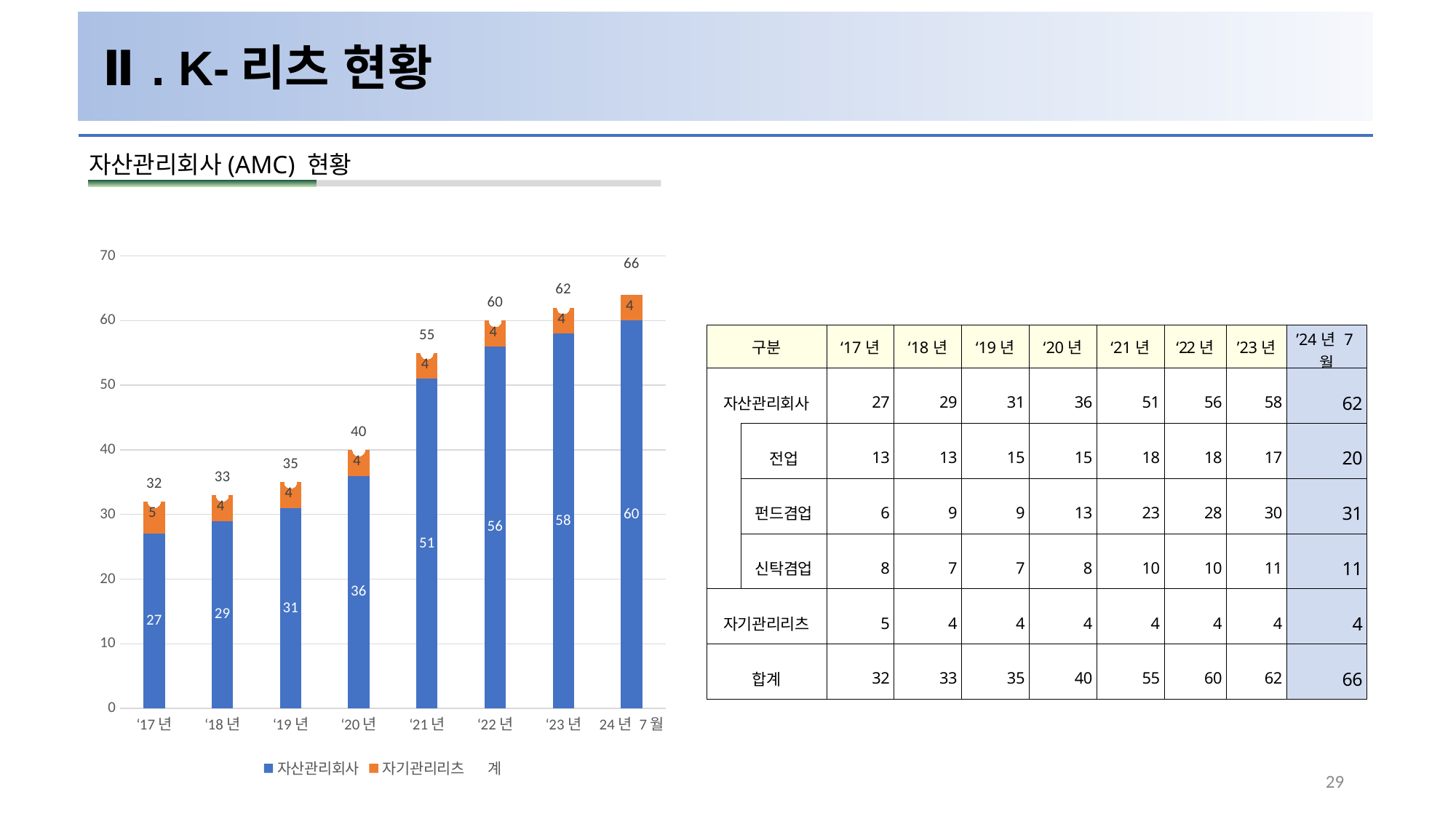
What type of chart is shown on the slide? stacked bar chart How many entries does the chart's legend list? 3 What is the difference between the 자산관리회사 values for '22년 and '19년? 25 Do the total values rise or fall from '17년 to 24년 7월? rise What is the total (계) shown above the bar for '20년? 40 Which is larger, the 자산관리회사 value for '20년 or for '18년? '20년 Which year has the highest total in the chart? 24년 7월 How many year categories are shown on the x axis of the chart? 8 What is the value of 자기관리리츠 for '17년 in the chart? 5 What is the value of 자산관리회사 for '21년 in the chart? 51 Which year has the lowest total in the chart? '17년 Which colour represents 자기관리리츠 in the chart? orange